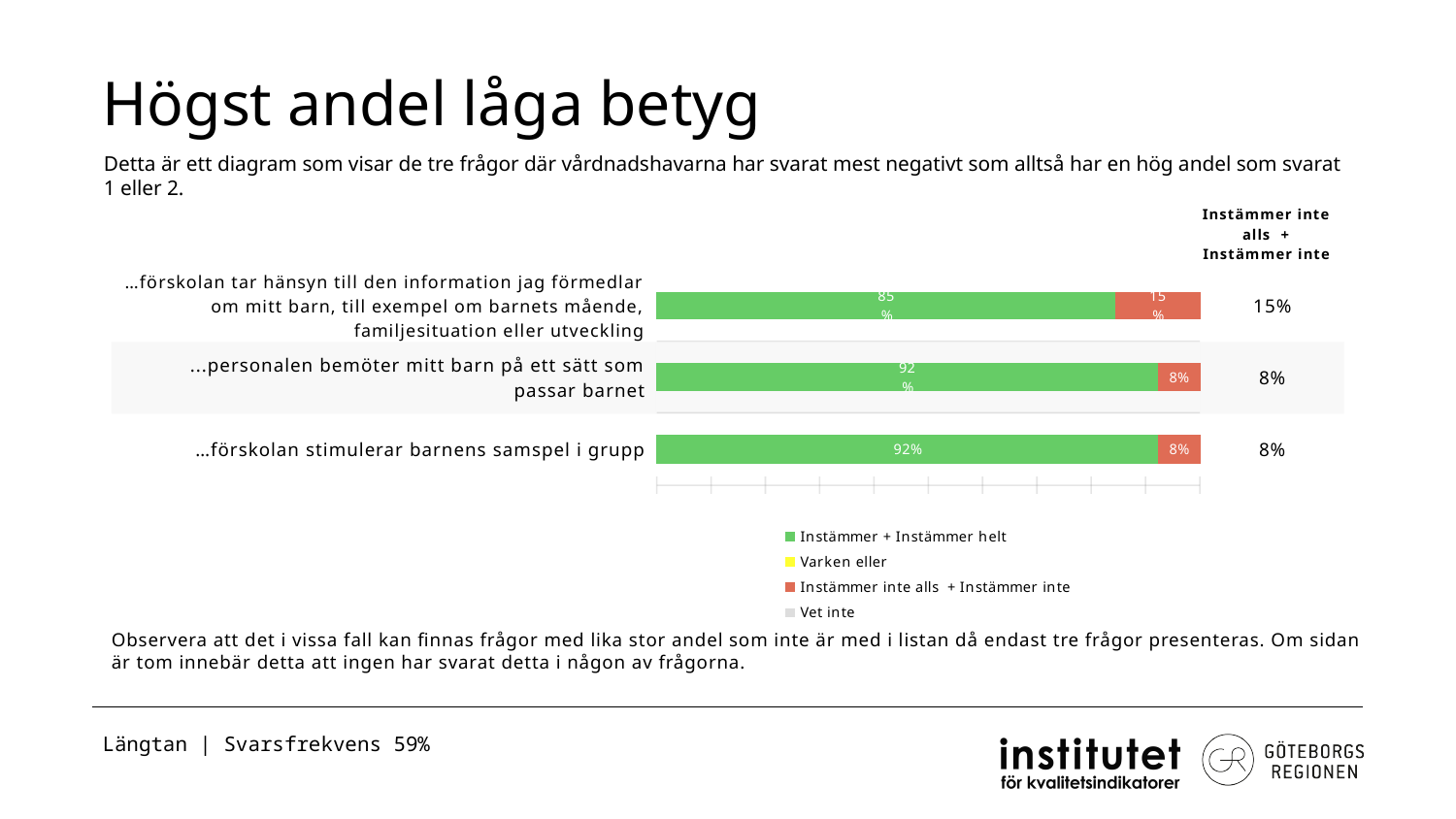
Which category has the lowest share of 'Instämmer + Instämmer helt'? …förskolan tar hänsyn till den information jag förmedlar om mitt barn, till exempel om barnets mående, familjesituation eller utveckling What is the value of 'Instämmer inte alls + Instämmer inte' for '…förskolan stimulerar barnens samspel i grupp'? 8% What is the value of 'Instämmer inte alls + Instämmer inte' for '…förskolan tar hänsyn till den information jag förmedlar om mitt barn, till exempel om barnets mående, familjesituation eller utveckling'? 15% What is the difference in 'Instämmer inte alls + Instämmer inte' between '…förskolan tar hänsyn till den information jag förmedlar…' and '…personalen bemöter mitt barn på ett sätt som passar barnet'? 7 percentage points How many categories (questions) are plotted in the chart? 3 How many series does the legend list? 4 What is the value of 'Instämmer + Instämmer helt' for '…personalen bemöter mitt barn på ett sätt som passar barnet'? 92% Which is larger: the 'Instämmer + Instämmer helt' share for '…förskolan stimulerar barnens samspel i grupp' or for '…förskolan tar hänsyn till den information jag förmedlar…'? …förskolan stimulerar barnens samspel i grupp What kind of chart is shown on the slide? stacked bar chart What is the value of 'Instämmer + Instämmer helt' for '…förskolan tar hänsyn till den information jag förmedlar om mitt barn, till exempel om barnets mående, familjesituation eller utveckling'? 85% Which category has the highest share of 'Instämmer inte alls + Instämmer inte'? …förskolan tar hänsyn till den information jag förmedlar om mitt barn, till exempel om barnets mående, familjesituation eller utveckling What colour represents 'Instämmer inte alls + Instämmer inte' in the chart? red